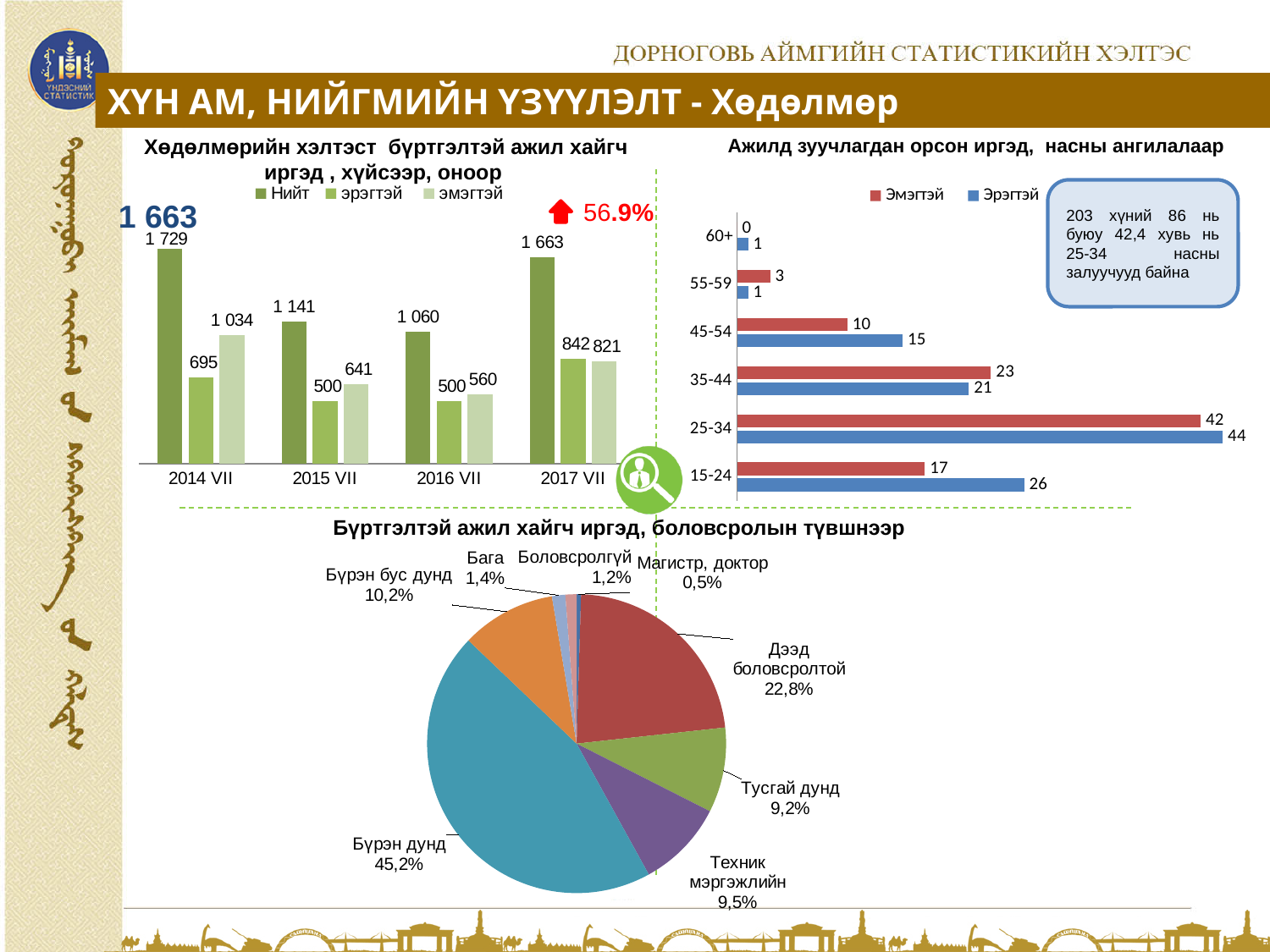
In the top-left chart, what is the difference between the Нийт values for 2014 VII and 2017 VII? 66 What type of chart is the bottom chart 'Бүртгэлтэй ажил хайгч иргэд, боловсролын түвшнээр'? pie chart In the top-left chart, how many series does the legend list? 3 In the top-right chart, what is the Эмэгтэй value for the 15-24 age group? 17 In the top-left chart 'Хөдөлмөрийн хэлтэст бүртгэлтэй ажил хайгч иргэд, хүйсээр, оноор', what is the Нийт value for 2017 VII? 1 663 In the top-right chart, is the Эмэгтэй value for 35-44 larger or smaller than the Эрэгтэй value for 35-44? larger In the top-right chart 'Ажилд зуучлагдан орсон иргэд, насны ангилалаар', what is the Эрэгтэй value for the 25-34 age group? 44 In the top-left chart, what is the эмэгтэй value for 2014 VII? 1 034 In the bottom pie chart 'Бүртгэлтэй ажил хайгч иргэд, боловсролын түвшнээр', what share does Бүрэн дунд have? 45,2% In the top-left chart, which year has the highest Нийт value? 2014 VII In the top-right chart, how many age groups are shown? 6 In the top-right chart, which age group has the lowest Эмэгтэй value? 60+